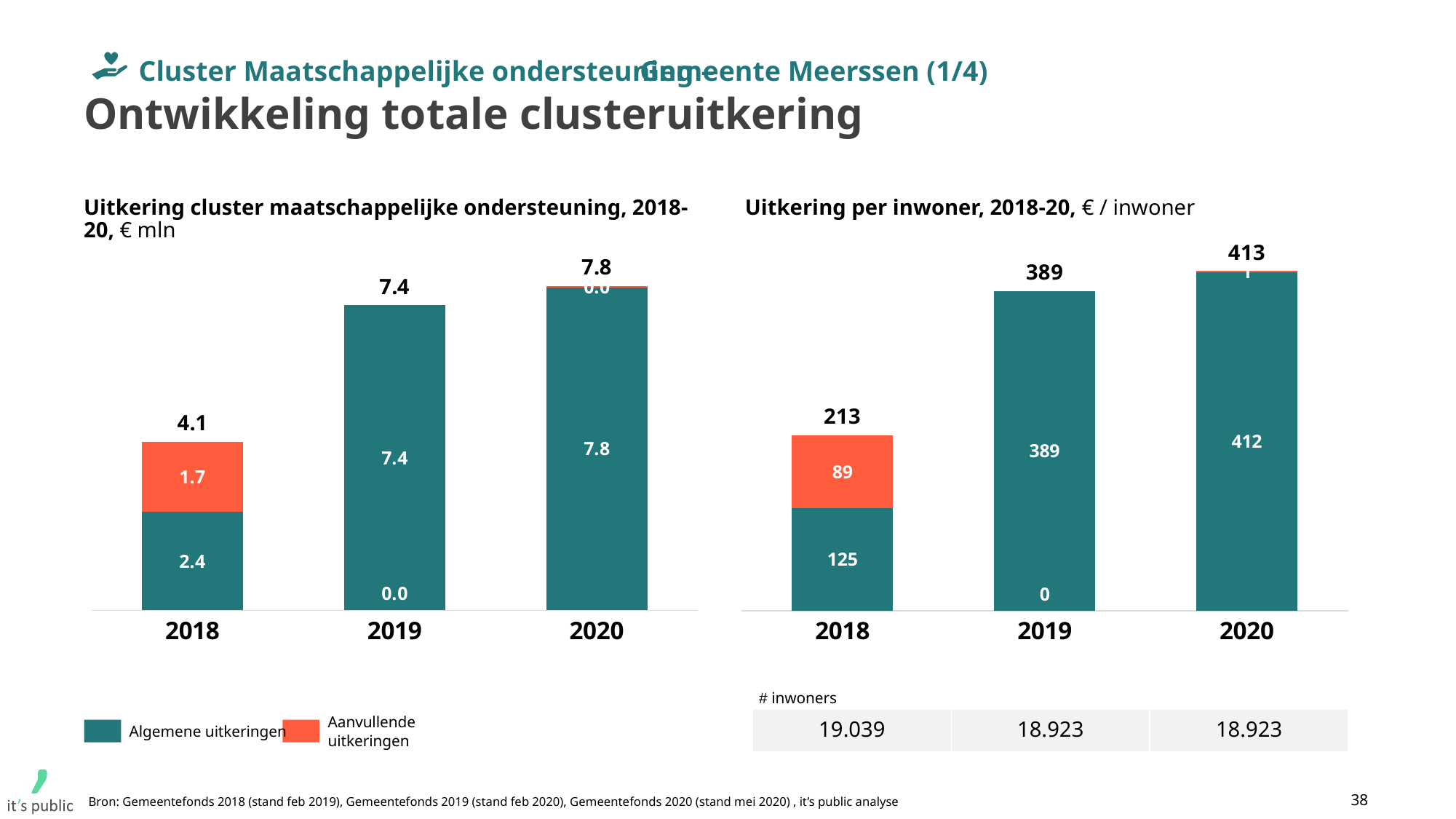
In the right chart (Uitkering per inwoner), what is the difference between the 2019 total and the 2018 total? 176 In the left chart (Uitkering cluster maatschappelijke ondersteuning), what is the value of Aanvullende uitkeringen in 2018? 1.7 In the left chart (Uitkering cluster maatschappelijke ondersteuning), what is the value of Algemene uitkeringen in 2019? 7.4 In the right chart (Uitkering per inwoner), what is the value of Algemene uitkeringen in 2020? 412 In the left chart (Uitkering cluster maatschappelijke ondersteuning), what is the total value for 2018? 4.1 In the right chart (Uitkering per inwoner), what is the total value for 2018? 213 In the right chart (Uitkering per inwoner), what is the value of Aanvullende uitkeringen in 2018? 89 In the left chart (Uitkering cluster maatschappelijke ondersteuning), which year has the highest total? 2020 In the left chart (Uitkering cluster maatschappelijke ondersteuning), what is the difference between the 2020 total and the 2018 total? 3.7 In the left chart (Uitkering cluster maatschappelijke ondersteuning), do the totals rise or fall from 2018 to 2020? rise In the right chart (Uitkering per inwoner), which year has the lowest total? 2018 How many series does the legend on the slide list? 2